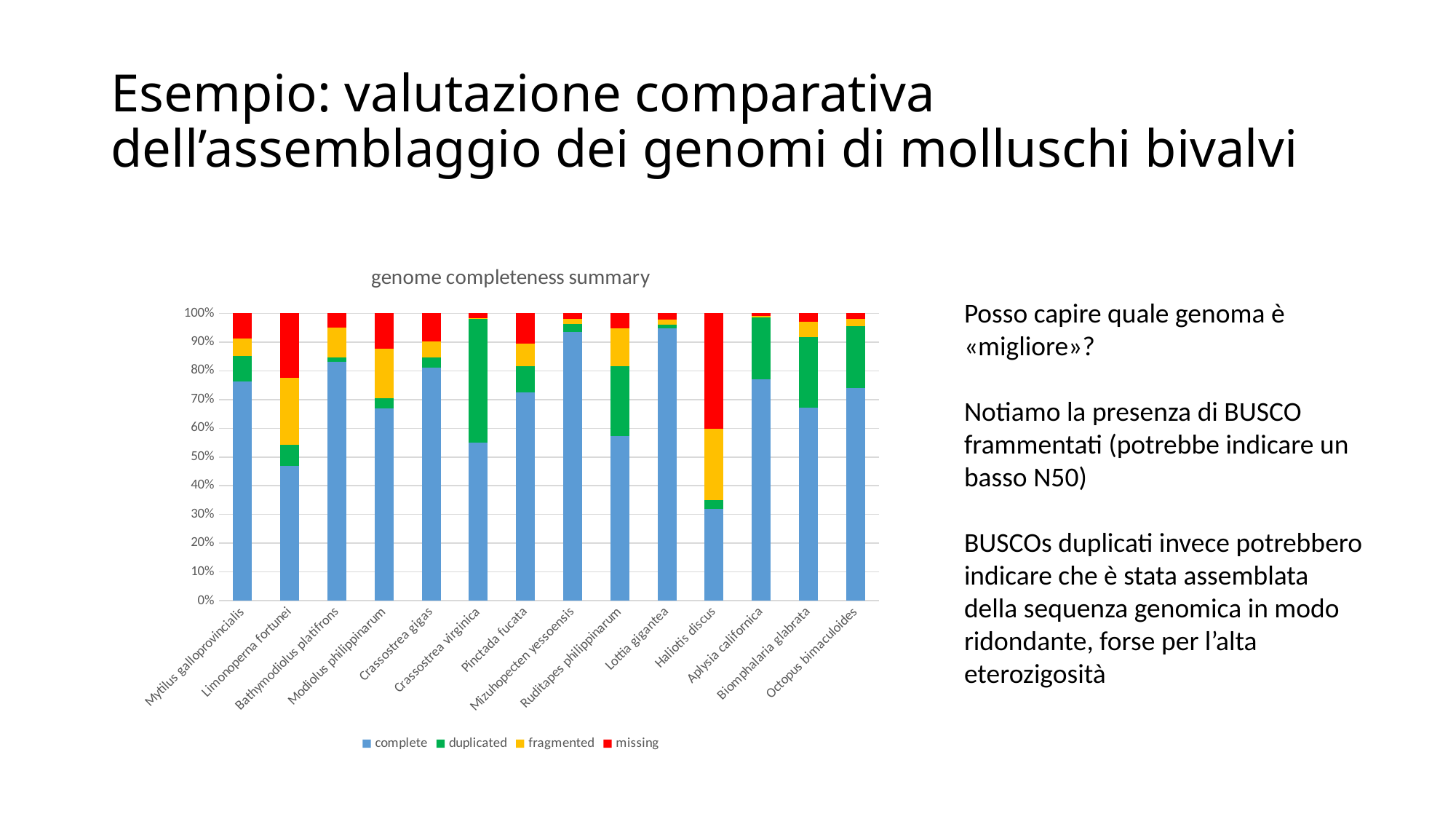
What does each stacked bar total on the y axis? 100% What is the title of the chart? genome completeness summary Which series is shown in red in the chart? missing What kind of chart is shown on the slide? Stacked bar chart Which species has the largest 'duplicated' share? Crassostrea virginica Which species has the lowest 'complete' share? Haliotis discus How many species (categories) are plotted on the x axis? 14 How many series does the chart legend list? 4 Which species has the largest 'missing' share? Haliotis discus Which has a larger 'complete' share, Mytilus galloprovincialis or Limnoperna fortunei? Mytilus galloprovincialis Is the 'complete' value for Mytilus galloprovincialis greater or less than 70%? greater Is the 'complete' value for Haliotis discus greater or less than 40%? less